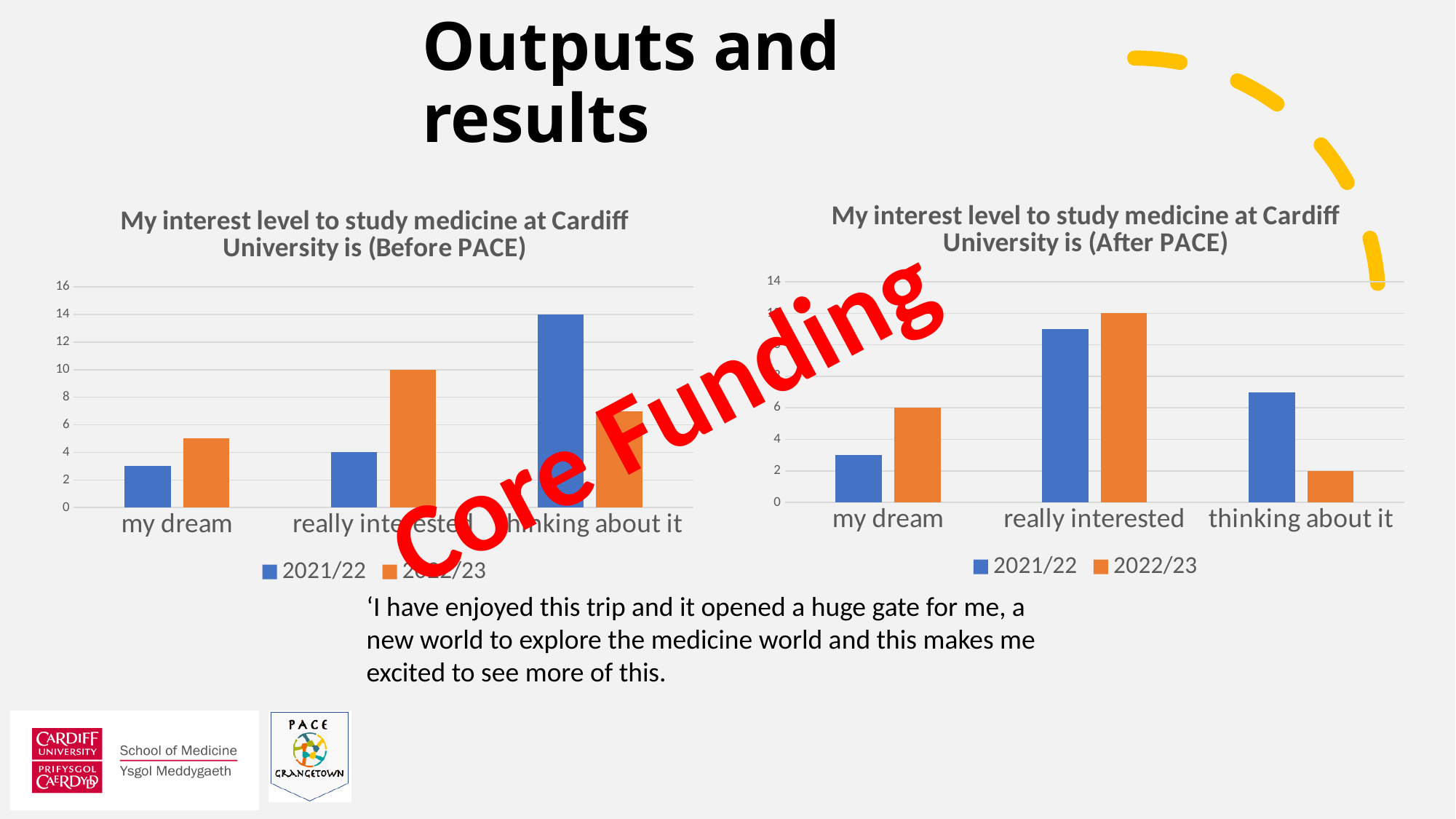
In the 'After PACE' chart, what is the value for 'thinking about it' in the 2022/23 series? 2 How many categories are shown on the x axis of the 'Before PACE' chart? 3 In the 'Before PACE' chart, what is the value for 'thinking about it' in the 2021/22 series? 14 In the 'Before PACE' chart, is the 2022/23 value for 'my dream' greater or less than 4? greater In the 'After PACE' chart, which is larger for 'thinking about it': the 2021/22 value or the 2022/23 value? 2021/22 In the 'After PACE' chart, which category has the lowest value in the 2022/23 series? thinking about it In the 'Before PACE' chart, what is the value for 'really interested' in the 2022/23 series? 10 In the 'After PACE' chart, what is the value for 'my dream' in the 2022/23 series? 6 How many series does the legend of the 'After PACE' chart list? 2 What type of chart is the 'After PACE' chart? bar chart In the 'Before PACE' chart, which category has the highest value in the 2021/22 series? thinking about it In the 'After PACE' chart, is the 2021/22 value for 'really interested' greater or less than 10? greater